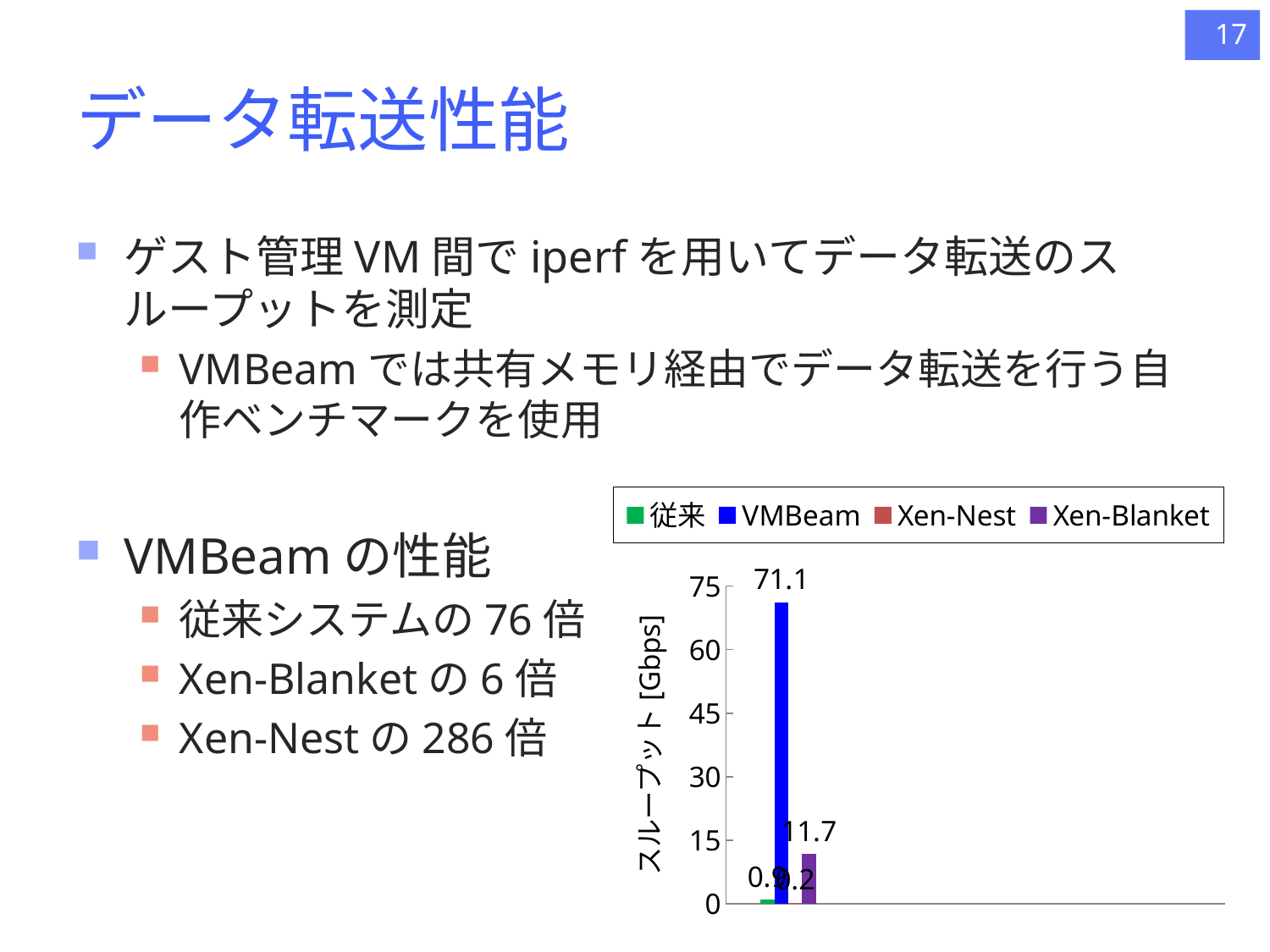
What is the throughput value for VMBeam? 71.1 What is the throughput value for Xen-Blanket? 11.7 What is the difference between the VMBeam and Xen-Blanket values? 59.4 Which is larger, the value for VMBeam or the value for Xen-Blanket? VMBeam What type of chart is shown on the slide? bar chart Is the value for Xen-Blanket greater or less than 15? less What is the label of the vertical axis? スループット [Gbps] Is the value for 従来 greater or less than 15? less Which series has the highest throughput? VMBeam How many series does the chart legend list? 4 What colour is the VMBeam bar? blue Is the value for VMBeam greater or less than 60? greater